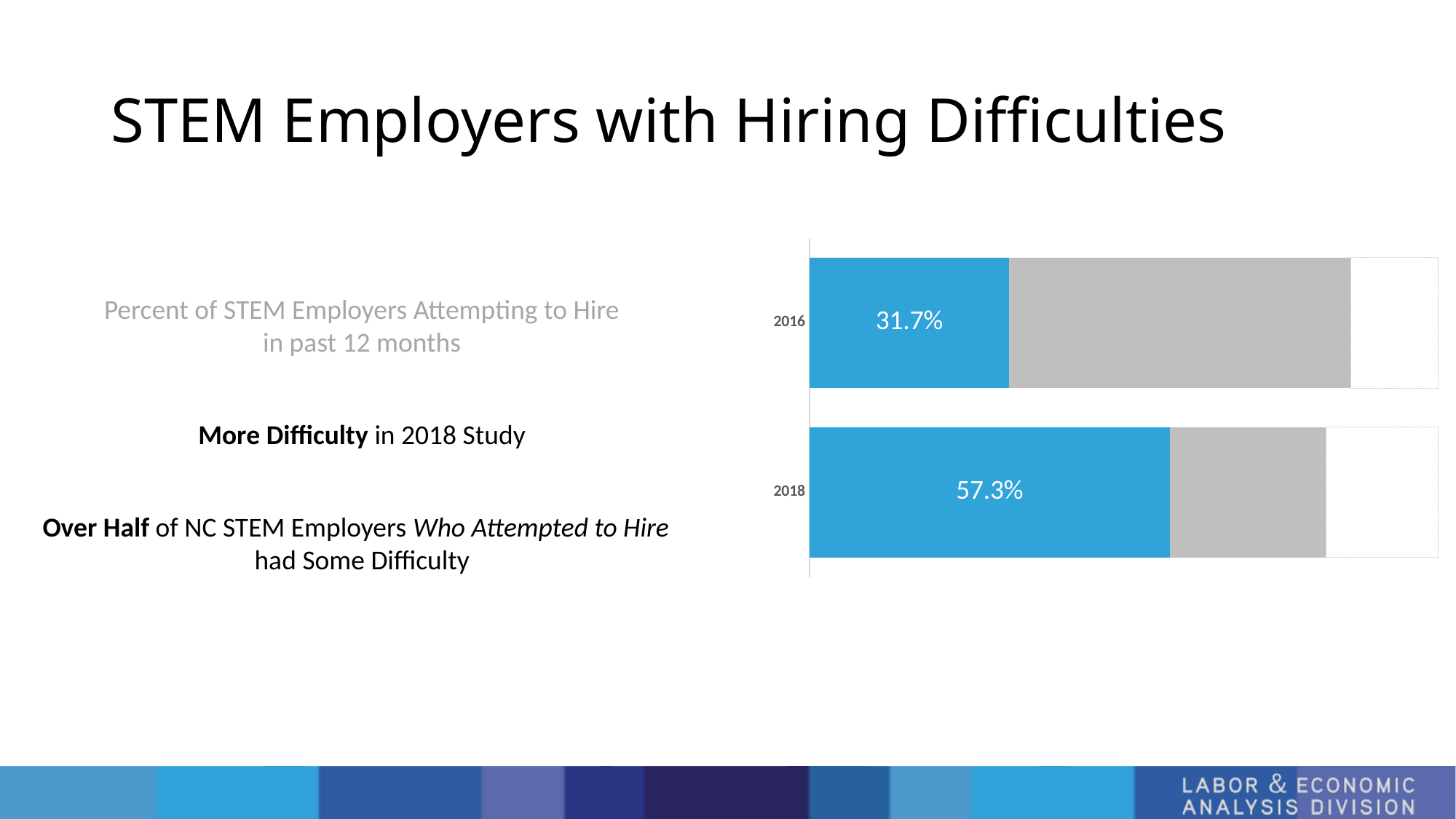
What is the labelled value for 2016 in the chart? 31.7% Which year has the lower labelled value in the chart? 2016 What kind of chart is shown on the slide? bar chart By how many percentage points does the 2018 value exceed the 2016 value? 25.6 percentage points What colour are the bar segments that carry the percentage labels? blue Does the labelled value rise or fall from 2016 to 2018? rise Is the labelled value for 2016 larger or smaller than the labelled value for 2018? smaller Which year has the higher labelled value in the chart? 2018 How many years (categories) are shown in the chart? 2 What is the labelled value for 2018 in the chart? 57.3% Are the bars in the chart drawn horizontally or vertically? horizontally